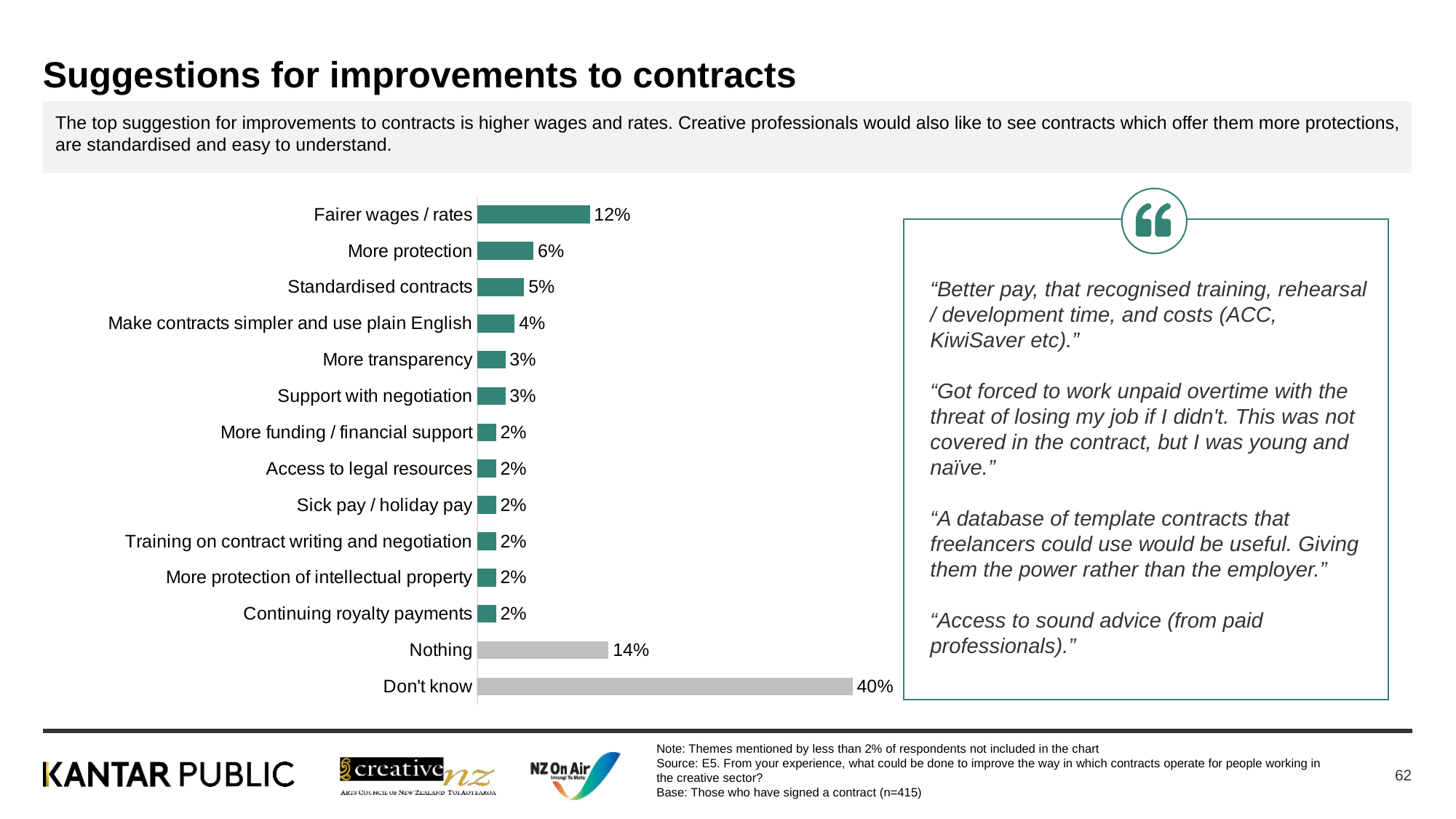
What is the value shown for 'Don't know'? 40% What type of chart is shown on the slide? Bar chart What is the difference between the values for 'Fairer wages / rates' and 'More protection'? 6% Among the suggested improvements (excluding 'Nothing' and 'Don't know'), which has the highest value? Fairer wages / rates How many categories are shown in the chart? 14 Which bars are coloured grey rather than green? Nothing and Don't know What percentage suggested making contracts simpler and using plain English? 4% What is the value for 'Nothing'? 14% Which is larger, the value for 'Standardised contracts' or 'More transparency'? Standardised contracts What is the difference between 'Don't know' and 'Nothing'? 26% What percentage of respondents suggested fairer wages / rates? 12% Which category has the highest value in the chart? Don't know